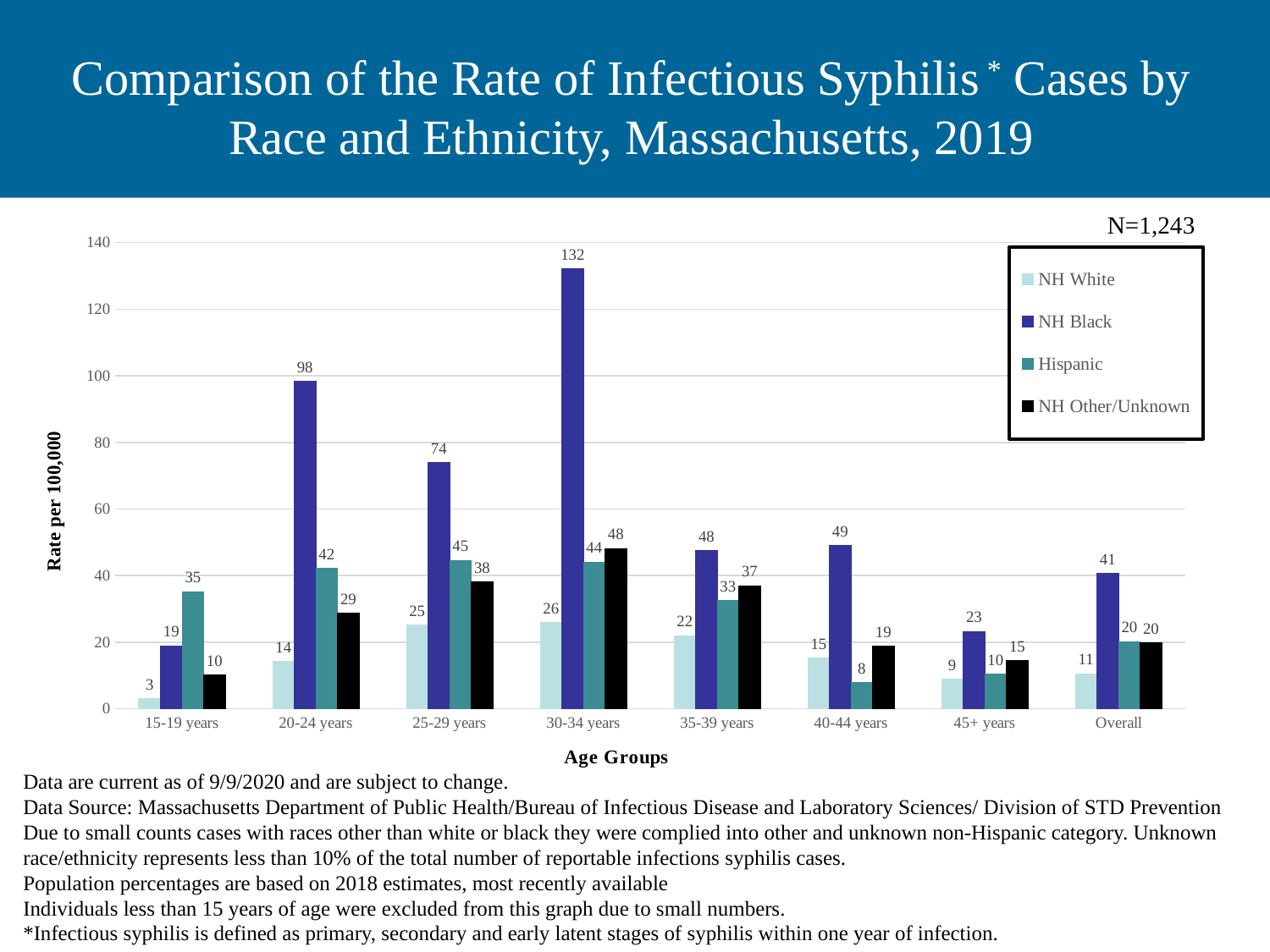
What is the Overall rate per 100,000 for NH White? 11 How many series does the legend list? 4 What is the rate per 100,000 for NH Black in the 30-34 years age group? 132 In the 40-44 years age group, which is larger: the Hispanic rate or the NH Other/Unknown rate? NH Other/Unknown How many age group categories are shown on the x axis, including Overall? 8 What is the rate per 100,000 for Hispanic in the 15-19 years age group? 35 What is the difference between the NH Black rate and the NH White rate in the 20-24 years age group? 84 What is the label of the y axis? Rate per 100,000 What kind of chart is shown on the slide? Bar chart Which age group has the highest rate for NH Black? 30-34 years Which age group has the lowest rate for NH White? 15-19 years What is the total number of cases (N) shown on the slide? N=1,243